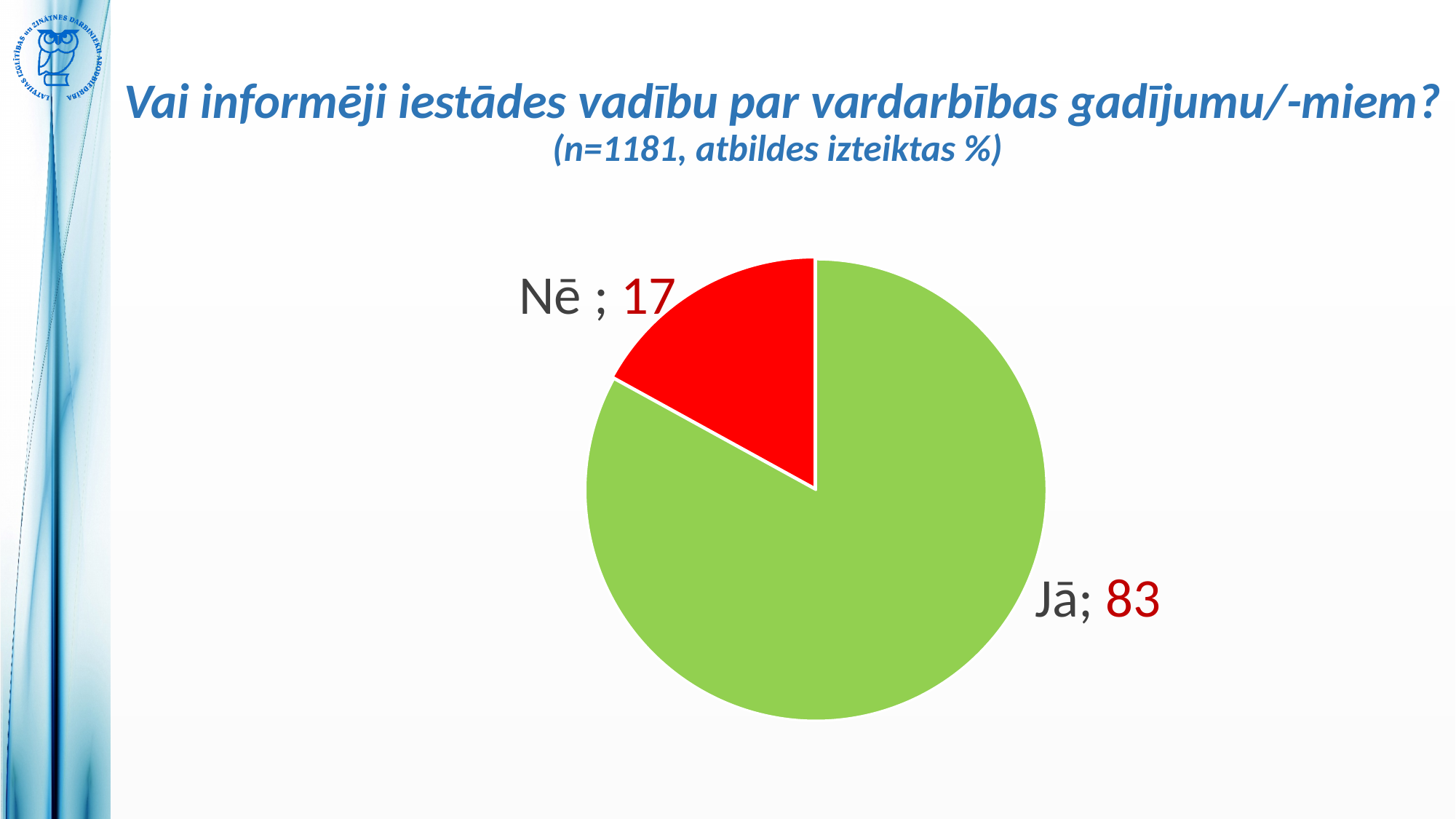
What is the sample size (n) stated in the chart subtitle? 1181 What colour is the "Jā" slice? green What is the difference between the values for "Jā" and "Nē"? 66 What share of the pie does the "Nē" slice represent? 17% Which is larger, the value for "Jā" or the value for "Nē"? Jā What is the value for "Nē"? 17 Which category has the smallest slice? Nē What is the value for "Jā"? 83 Which category has the largest slice? Jā How many slices does the pie chart have? 2 What kind of chart is shown on the slide? pie chart